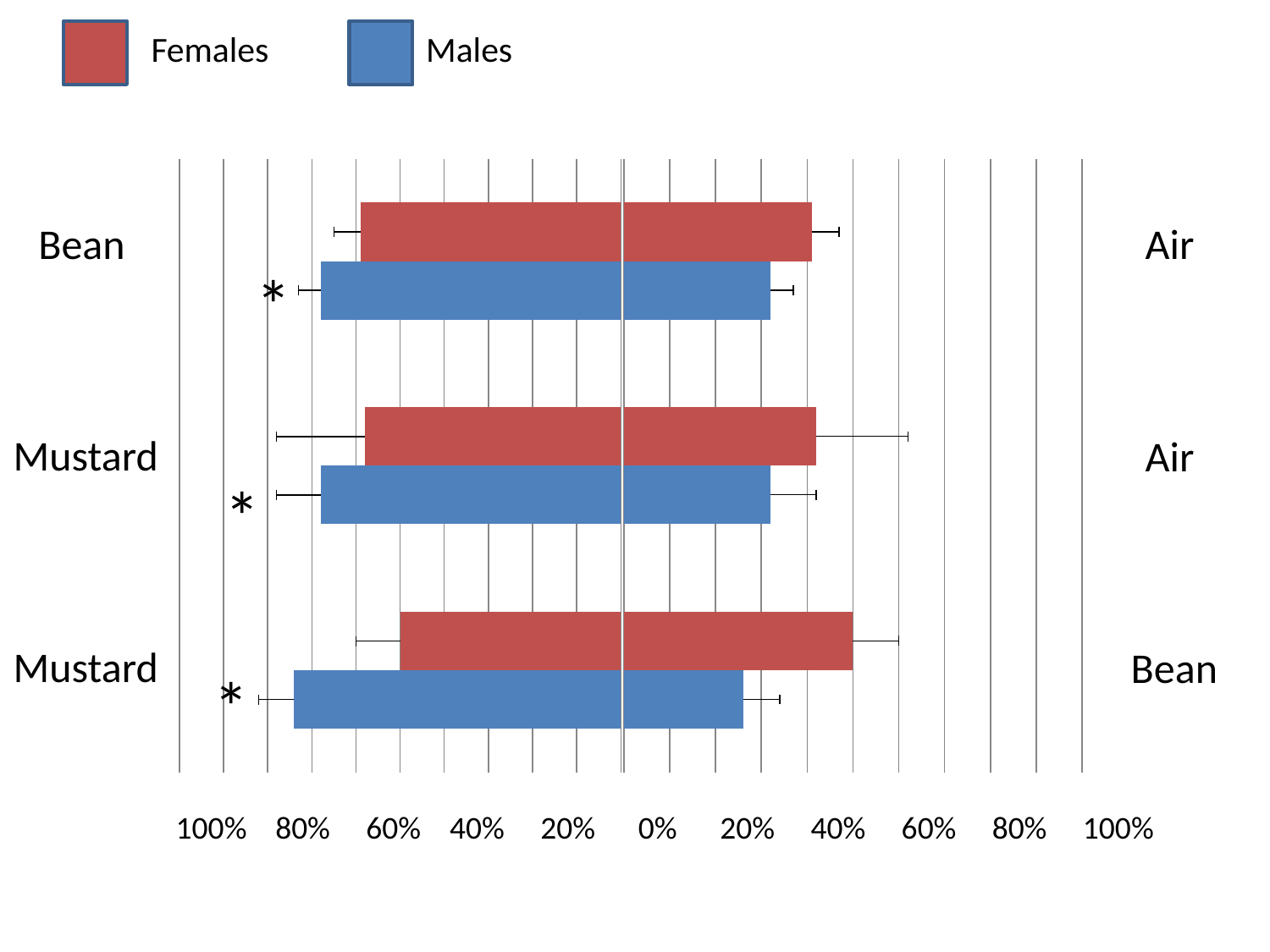
How many series does the legend list? 2 In the Mustard vs Bean row, is the Females bar extending toward Bean (right side) greater or less than 40%? greater In the Mustard vs Air row, is the Females bar extending toward Mustard (left side) greater or less than 80%? less What kind of chart is shown on the slide? bar chart In the Bean vs Air row, is the Males bar extending toward Bean (left side) greater or less than 60%? greater Which colour represents Females in the legend? red In the Bean vs Air row, which series has the longer bar extending toward Air (right side), Females or Males? Females How many pairs of bars (rows) are plotted on the chart? 3 In the Mustard vs Bean row, which series has the longer bar extending toward Mustard (left side), Females or Males? Males Which colour represents Males in the legend? blue